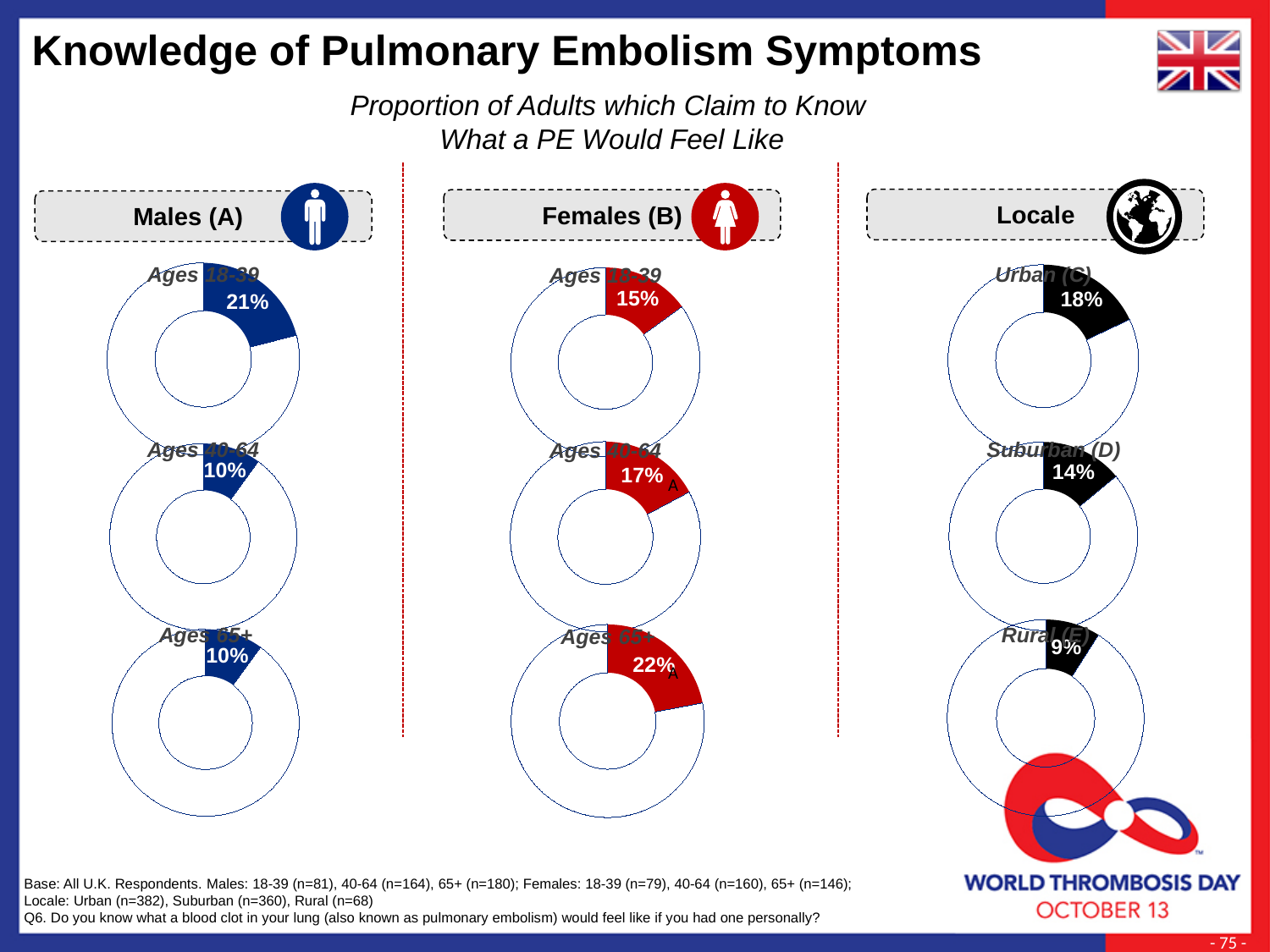
In the Females (B) column, what percentage of adults aged 65+ claim to know what a PE would feel like? 22% In the Males (A) column, what percentage of adults aged 18-39 claim to know what a PE would feel like? 21% Among the three Females (B) donut charts, which age group has the lowest percentage? Ages 18-39 What is the difference between the Females (B) ages 65+ percentage and the Males (A) ages 65+ percentage? 12 percentage points How many donut charts are shown on the slide in total? 9 In the Locale column, what percentage of Rural (E) adults claim to know what a PE would feel like? 9% In the Females (B) column, what percentage of adults aged 40-64 claim to know what a PE would feel like? 17% In the Locale column, what percentage of Suburban (D) adults claim to know what a PE would feel like? 14% What type of chart is used to show each percentage on the slide? Donut (pie) chart Among the three Males (A) donut charts, which age group has the highest percentage? Ages 18-39 Among the three Locale donut charts, which locale has the highest percentage? Urban (C) Which is larger: the Males (A) ages 18-39 percentage or the Females (B) ages 18-39 percentage? Males (A) ages 18-39